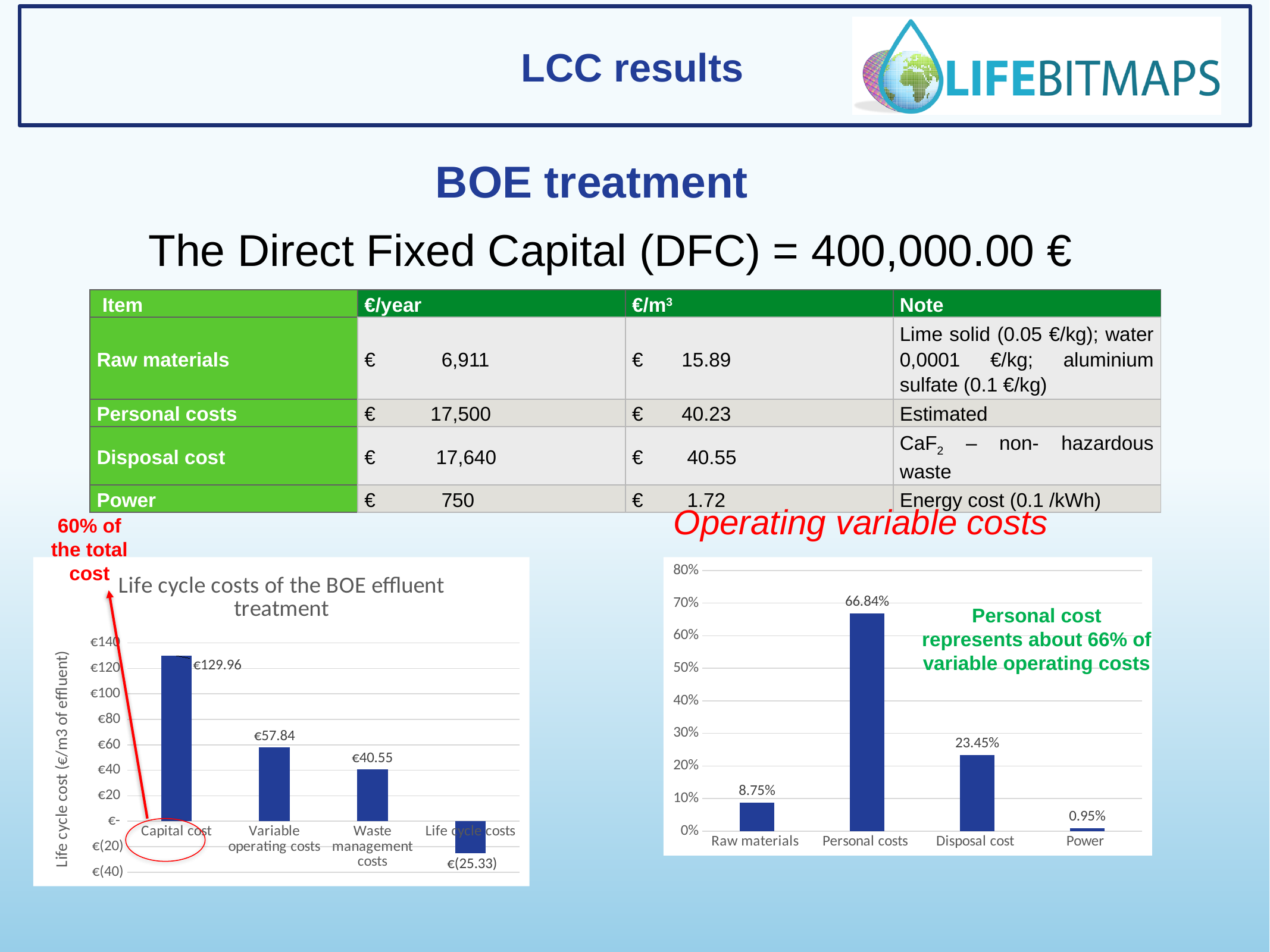
In the 'Life cycle costs of the BOE effluent treatment' chart, which category has the highest value? Capital cost What kind of chart is the 'Life cycle costs of the BOE effluent treatment' chart? Bar chart In the Operating variable costs chart on the right, what is the difference between Personal costs and Disposal cost? 43.39% In the 'Life cycle costs of the BOE effluent treatment' chart, what is the value for Waste management costs? €40.55 In the 'Life cycle costs of the BOE effluent treatment' chart, what is the value for Life cycle costs? €(25.33) In the 'Life cycle costs of the BOE effluent treatment' chart, how many categories are shown on the x axis? 4 In the Operating variable costs chart on the right, what is the value for Raw materials? 8.75% In the Operating variable costs chart on the right, what is the value for Personal costs? 66.84% In the Operating variable costs chart on the right, which is larger: Disposal cost or Raw materials? Disposal cost In the Operating variable costs chart on the right, which category has the lowest value? Power In the 'Life cycle costs of the BOE effluent treatment' chart, what is the difference between Capital cost and Variable operating costs? €72.12 In the 'Life cycle costs of the BOE effluent treatment' chart, what is the value for Capital cost? €129.96